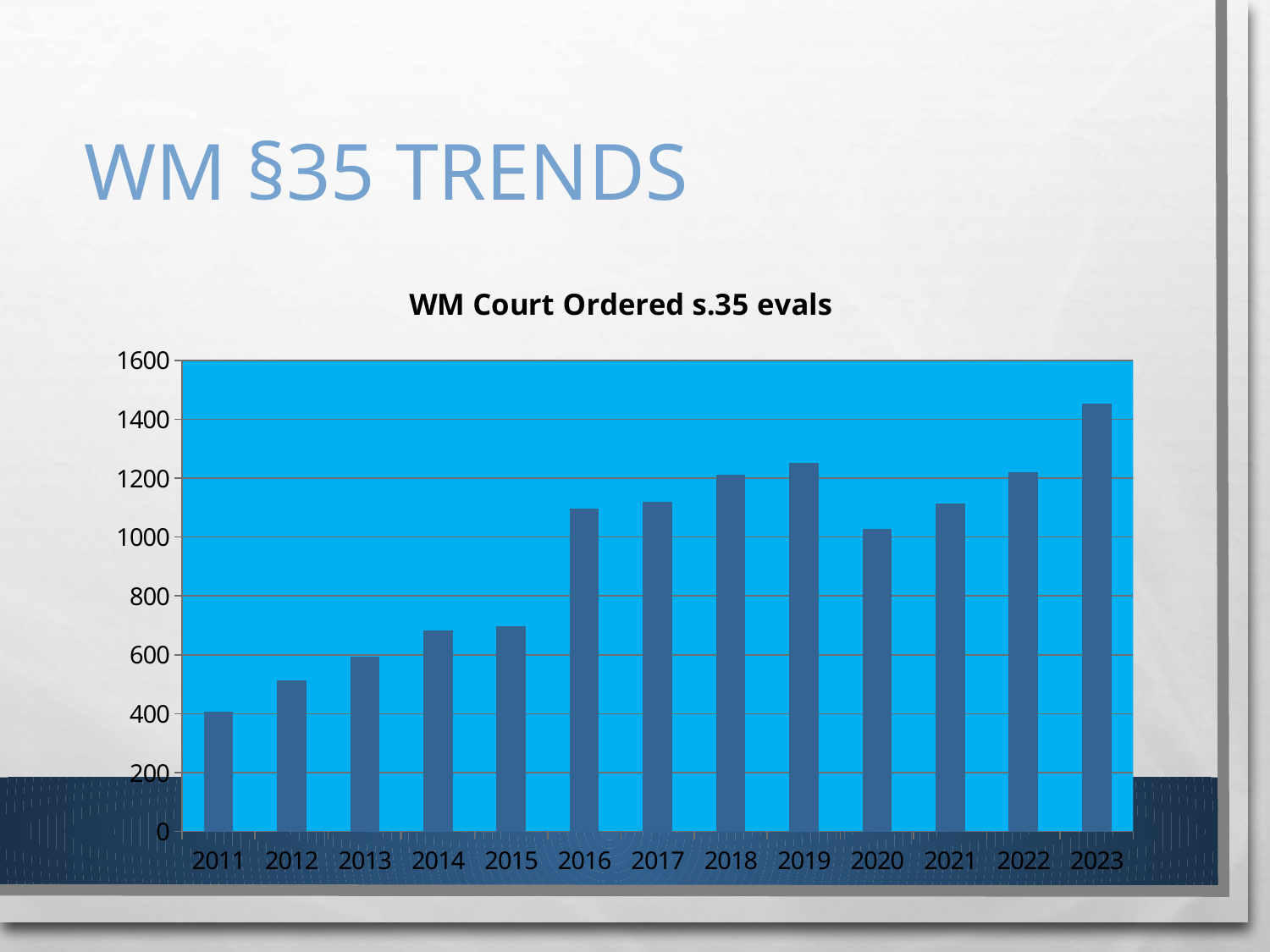
Is the value for 2023 greater or less than 1400? greater Which year has the larger value, 2019 or 2020? 2019 What type of chart is shown on the slide? bar chart Is the value for 2016 greater or less than 1000? greater What is the title of the chart? WM Court Ordered s.35 evals Is the value for 2015 greater or less than 800? less Which year has the lowest value in the chart? 2011 Which year has the highest value in the chart? 2023 How many years are shown on the x axis of the chart? 13 Which year has the larger value, 2012 or 2016? 2016